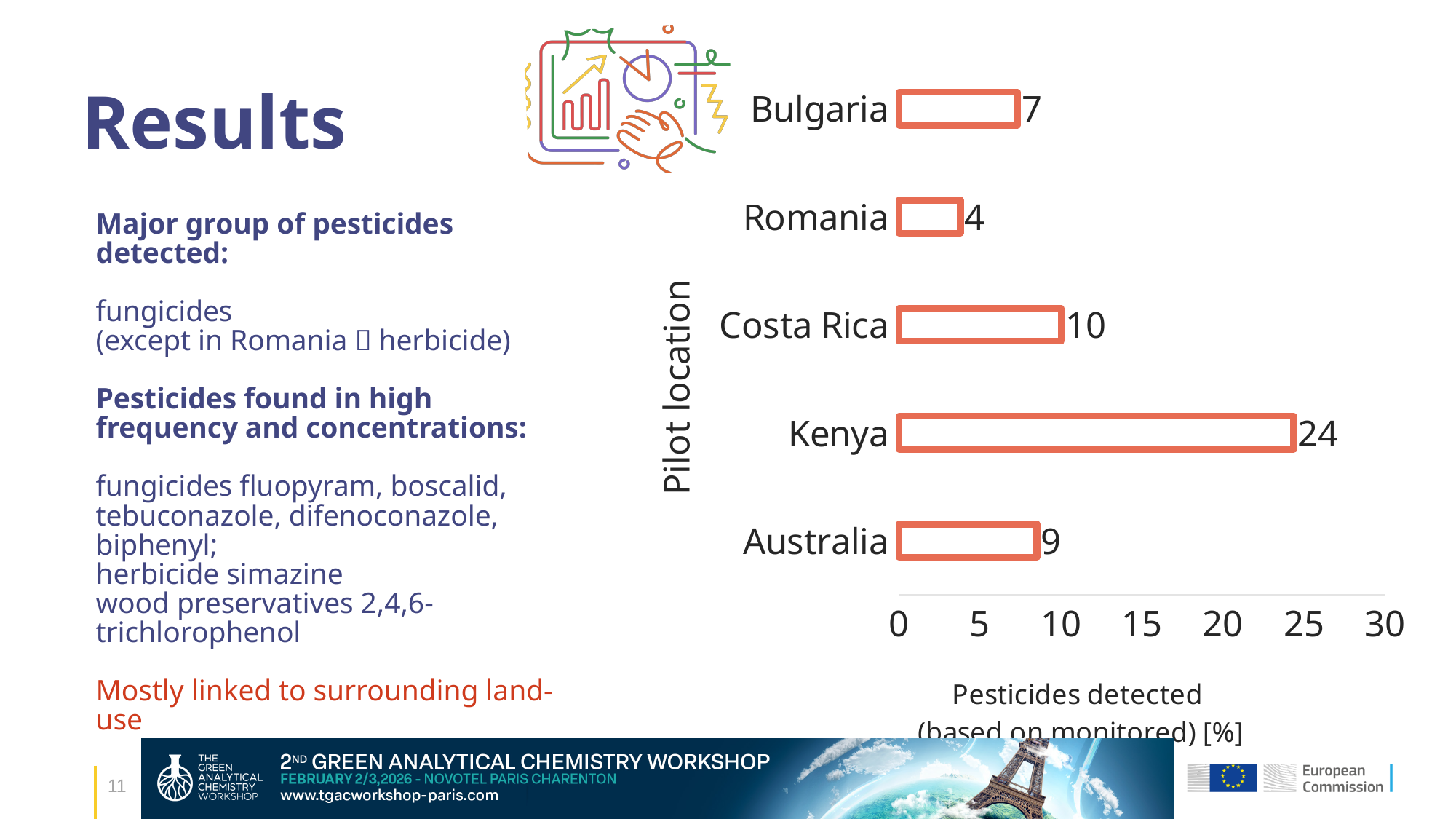
Which pilot location has the lowest value? Romania Which pilot location has the highest value? Kenya What is the value for Kenya? 24 What kind of chart is shown on the slide? bar chart What is the label of the vertical axis of the chart? Pilot location What is the value for Costa Rica? 10 Is the value for Kenya greater or less than 20? greater How many pilot locations are shown in the chart? 5 What is the value for Romania? 4 Which has a larger value, Australia or Bulgaria? Australia What is the difference between the values for Kenya and Costa Rica? 14 What is the value for Bulgaria? 7